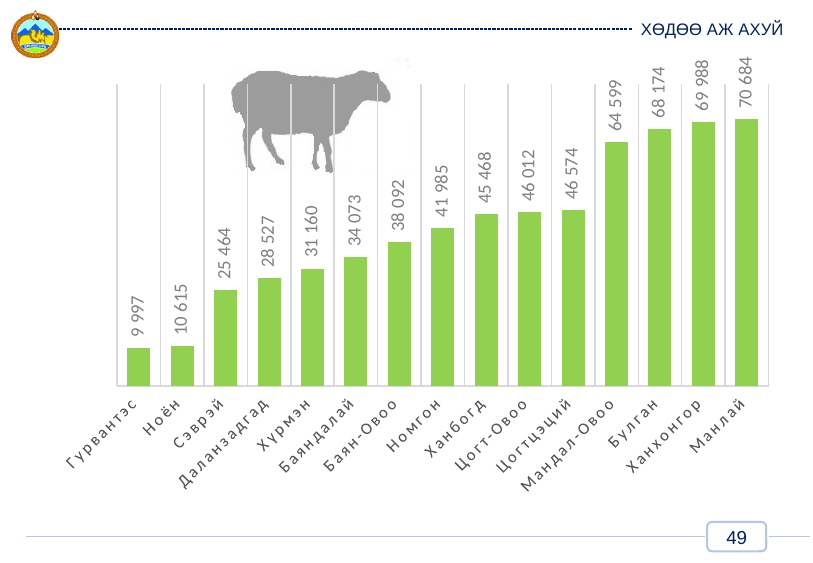
Which is larger, the value for Сэврэй or the value for Хүрмэн? Хүрмэн What is the difference between the values for Булган and Мандал-Овоо? 3 575 Which category has the lowest value? Гурвантэс What is the difference between the values for Манлай and Гурвантэс? 60 687 What kind of chart is shown on the slide? Bar chart Which is larger, the value for Номгон or the value for Баян-Овоо? Номгон What is the value for Ханбогд? 45 468 Do the values rise or fall from left to right along the x axis? Rise What is the value for Мандал-Овоо? 64 599 Which category has the highest value? Манлай How many categories are shown on the chart? 15 What is the value for Даланзадгад? 28 527